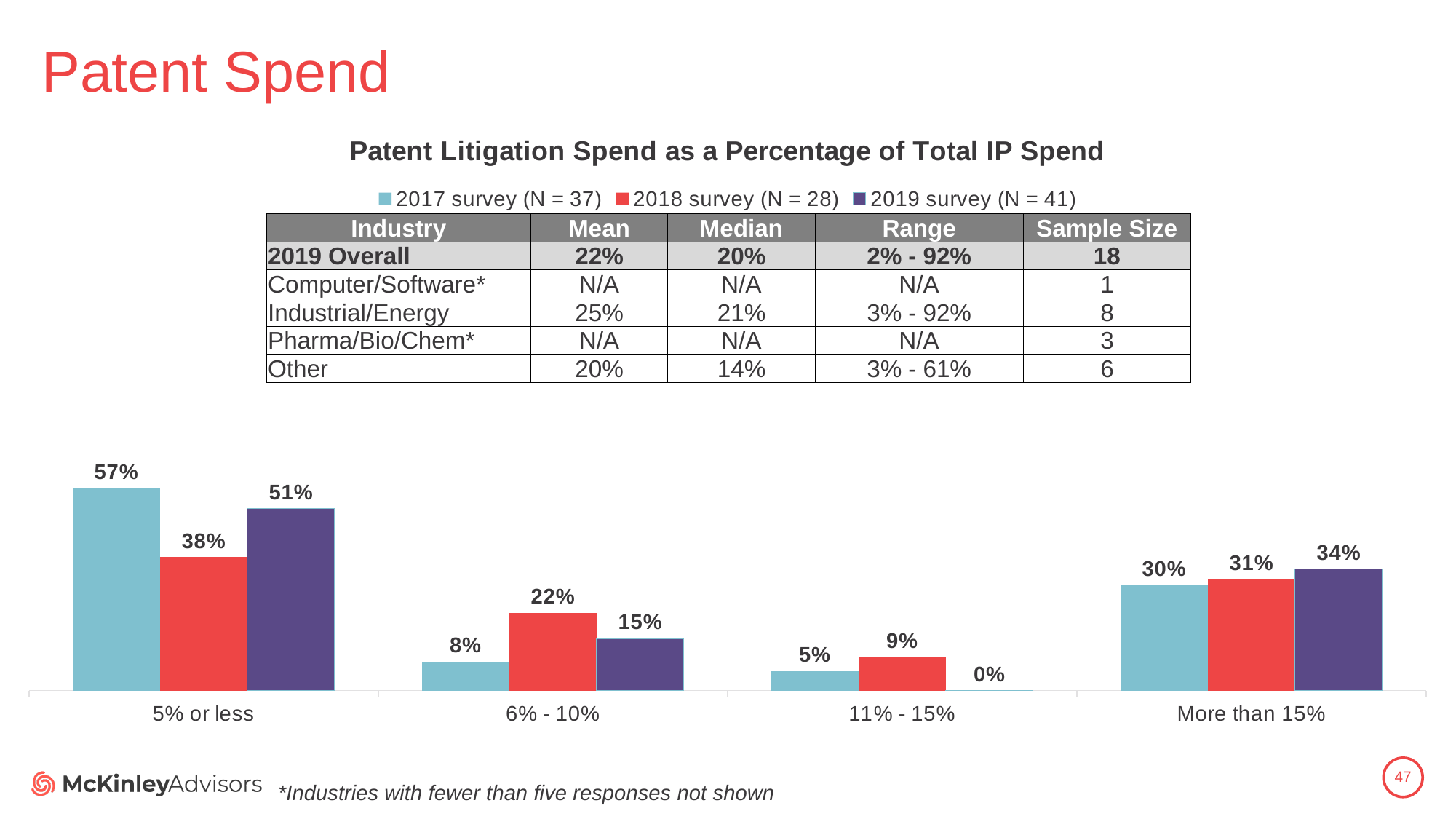
What is the value for the 2019 survey in the 'More than 15%' category? 34% How many categories are shown on the x axis of the chart? 4 What kind of chart is shown on the slide? Bar chart Which is larger in the '6% - 10%' category: the 2018 survey value or the 2019 survey value? 2018 survey What is the value for the 2019 survey in the '11% - 15%' category? 0% Which category has the highest value for the 2018 survey? 5% or less Which category has the lowest value for the 2017 survey? 11% - 15% What is the difference between the 2017 survey and 2019 survey values in the '5% or less' category? 6% What is the title of the chart? Patent Litigation Spend as a Percentage of Total IP Spend How many series does the chart legend list? 3 What is the value for the 2017 survey in the '5% or less' category? 57% What is the value for the 2018 survey in the '6% - 10%' category? 22%